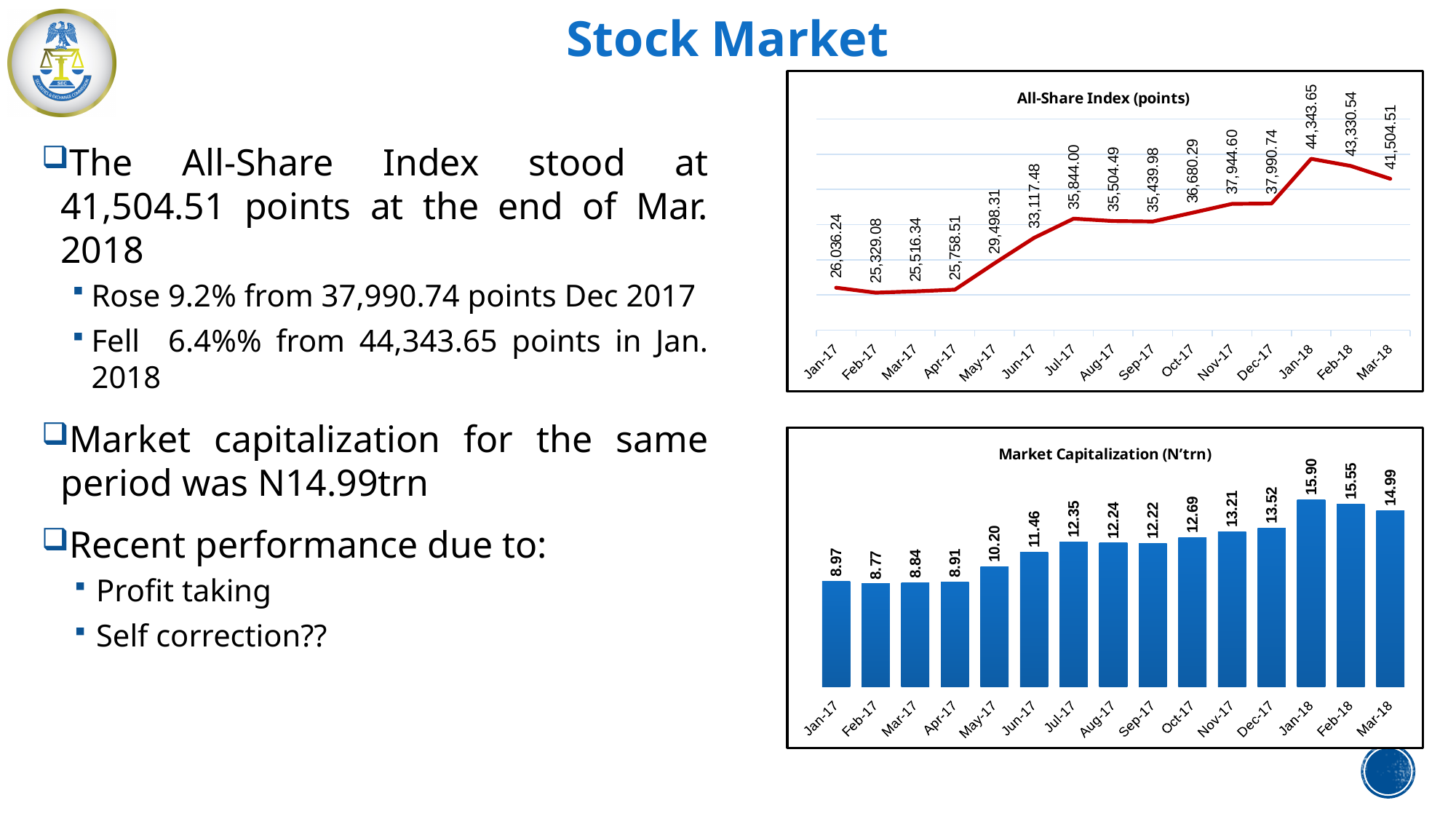
In the All-Share Index (points) chart, how many months are plotted? 15 In the All-Share Index (points) chart, what kind of chart is shown? Line chart In the All-Share Index (points) chart, which month has the highest value? Jan-18 In the All-Share Index (points) chart, what is the value for Mar-18? 41,504.51 In the Market Capitalization (N'trn) chart, which month has the lowest value? Feb-17 In the All-Share Index (points) chart, what is the value for Jan-18? 44,343.65 In the All-Share Index (points) chart, which month has the lowest value? Feb-17 In the Market Capitalization (N'trn) chart, what is the value for Dec-17? 13.52 In the Market Capitalization (N'trn) chart, what is the difference between Jan-18 and Mar-18? 0.91 In the Market Capitalization (N'trn) chart, which month has the highest value? Jan-18 In the Market Capitalization (N'trn) chart, what kind of chart is shown? Bar chart In the Market Capitalization (N'trn) chart, which is larger, Jul-17 or Aug-17? Jul-17